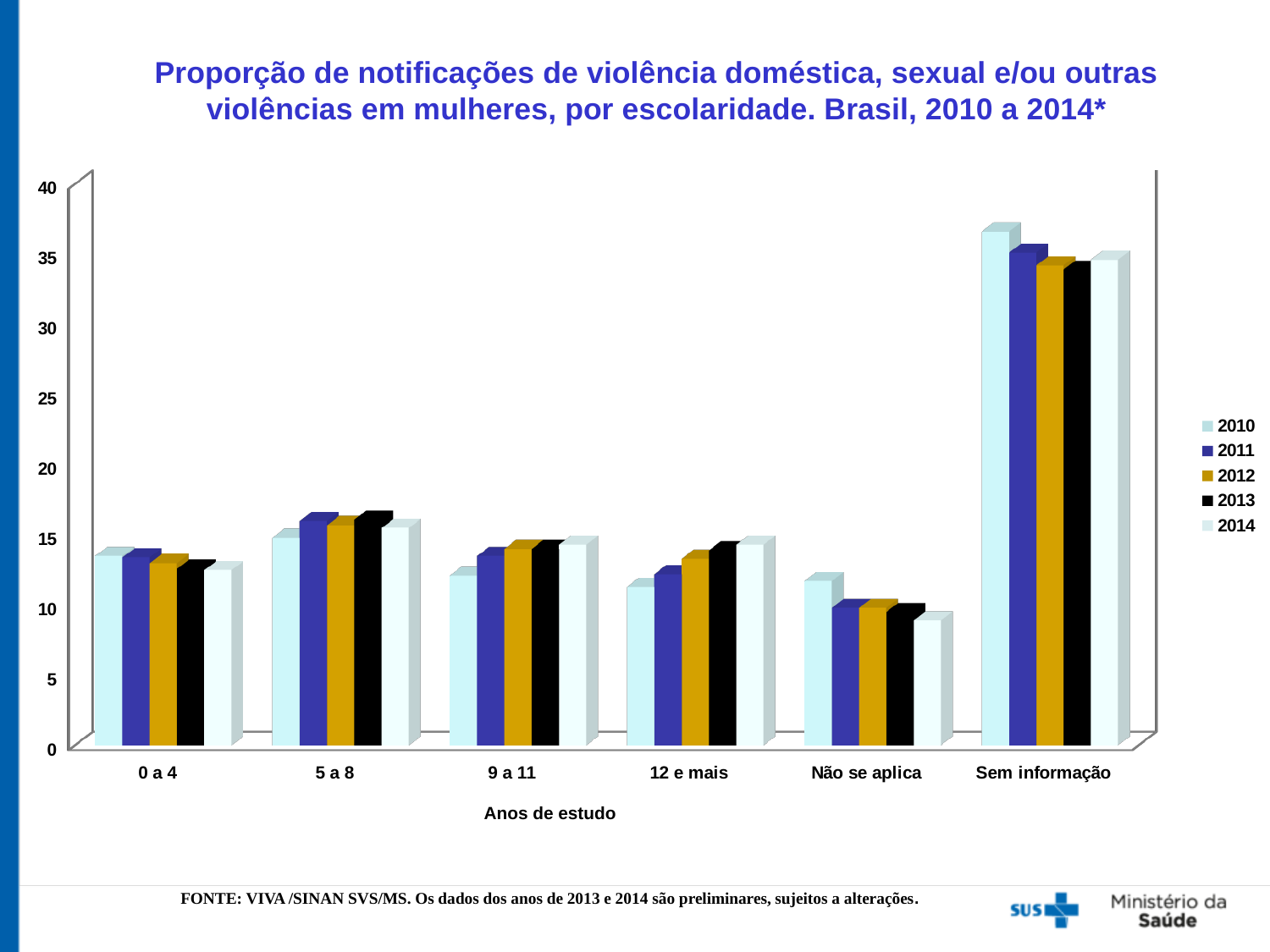
What kind of chart is shown on the slide? Bar chart Is the value for '5 a 8' in 2011 greater or less than 15? greater How many categories of 'Anos de estudo' are shown on the x axis? 6 Is the value for 'Sem informação' in 2010 greater or less than 35? greater For the category 'Sem informação', which year has the larger value, 2010 or 2013? 2010 Which category has the lowest value for 2014? Não se aplica Is the value for 'Não se aplica' in 2014 greater or less than 10? less For the category '12 e mais', which year has the larger value, 2010 or 2014? 2014 For the category '12 e mais', do the values rise or fall from 2010 to 2014? rise How many series does the legend list? 5 Which category has the highest value for 2010? Sem informação What is the title of the x axis? Anos de estudo